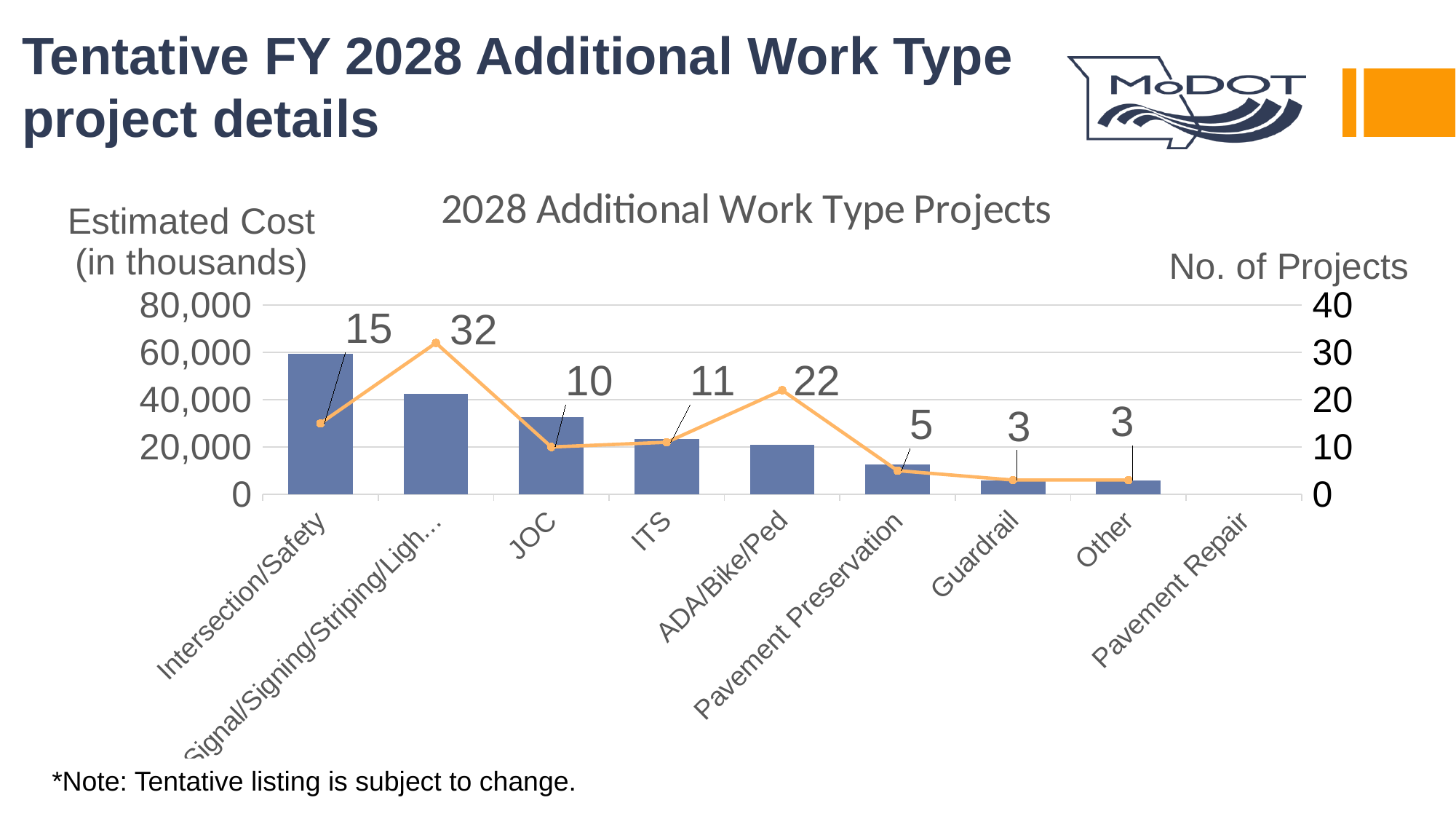
How many projects are shown for ADA/Bike/Ped? 22 Which work type has the tallest estimated cost bar? Intersection/Safety How many projects are shown for Signal/Signing/Striping/Ligh...? 32 How many work type categories are listed on the x axis? 9 What is the title of the right-hand axis? No. of Projects What is the difference between the number of projects for Signal/Signing/Striping/Ligh... and Intersection/Safety? 17 What kind of chart is shown on the slide? A bar chart combined with a line chart Is the estimated cost for Intersection/Safety greater or less than 40,000? greater Which has more projects, JOC or ITS? ITS Is the estimated cost for Pavement Preservation greater or less than 20,000? less How many projects are shown for Guardrail? 3 Which work type has the highest number of projects? Signal/Signing/Striping/Ligh...